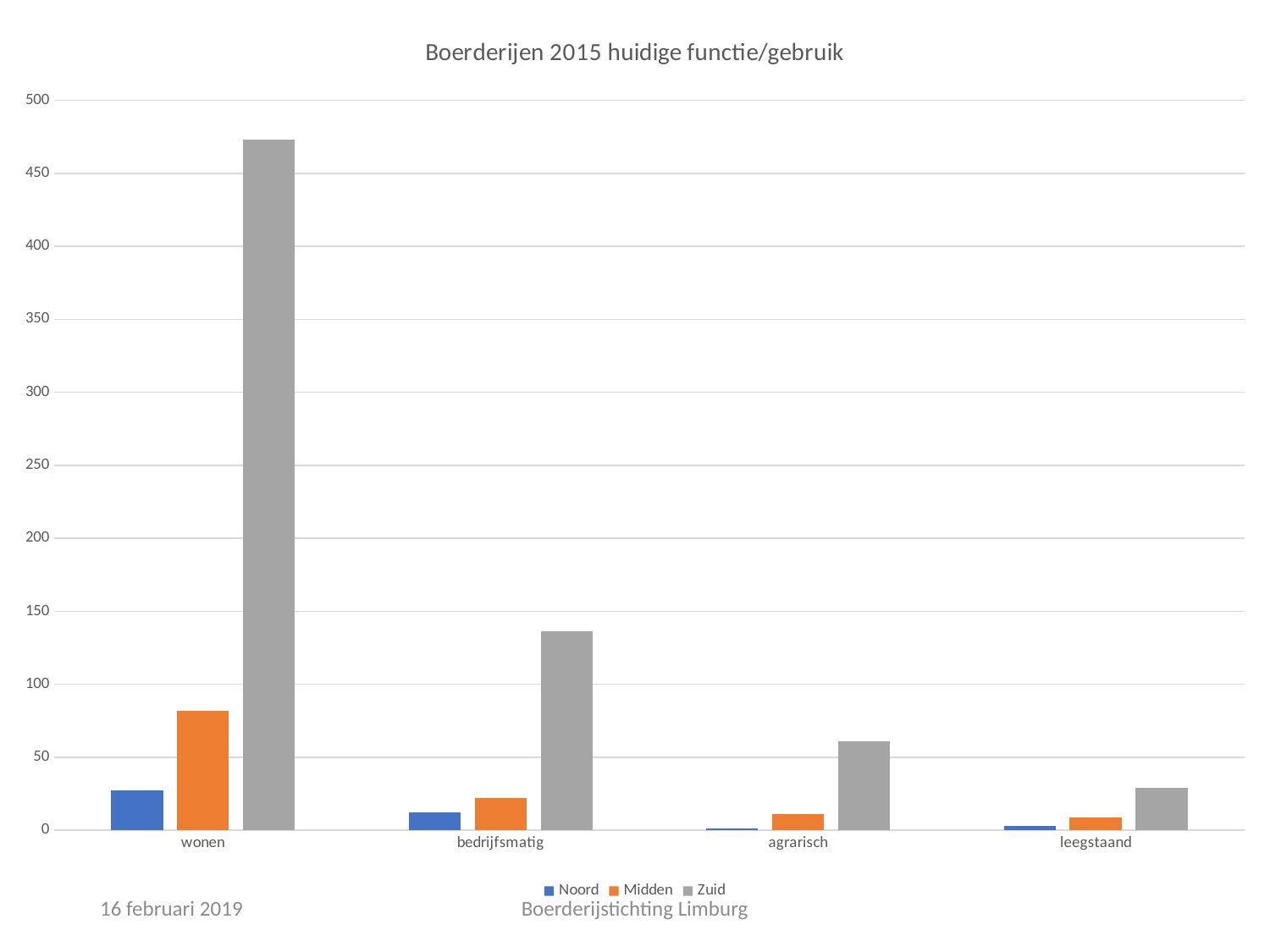
Is the value for Zuid in the wonen category greater or less than 450? greater Is the value for Zuid in the bedrijfsmatig category greater or less than 150? less Which series is shown in orange in the legend? Midden What is the title of the chart? Boerderijen 2015 huidige functie/gebruik Is the value for Zuid in the leegstaand category greater or less than 50? less How many series does the legend list? 3 Which category has the highest value for the Zuid series? wonen Which category has the lowest value for the Noord series? agrarisch What type of chart is shown on the slide? bar chart Which is larger in the bedrijfsmatig category: Noord or Midden? Midden How many categories are shown on the x axis? 4